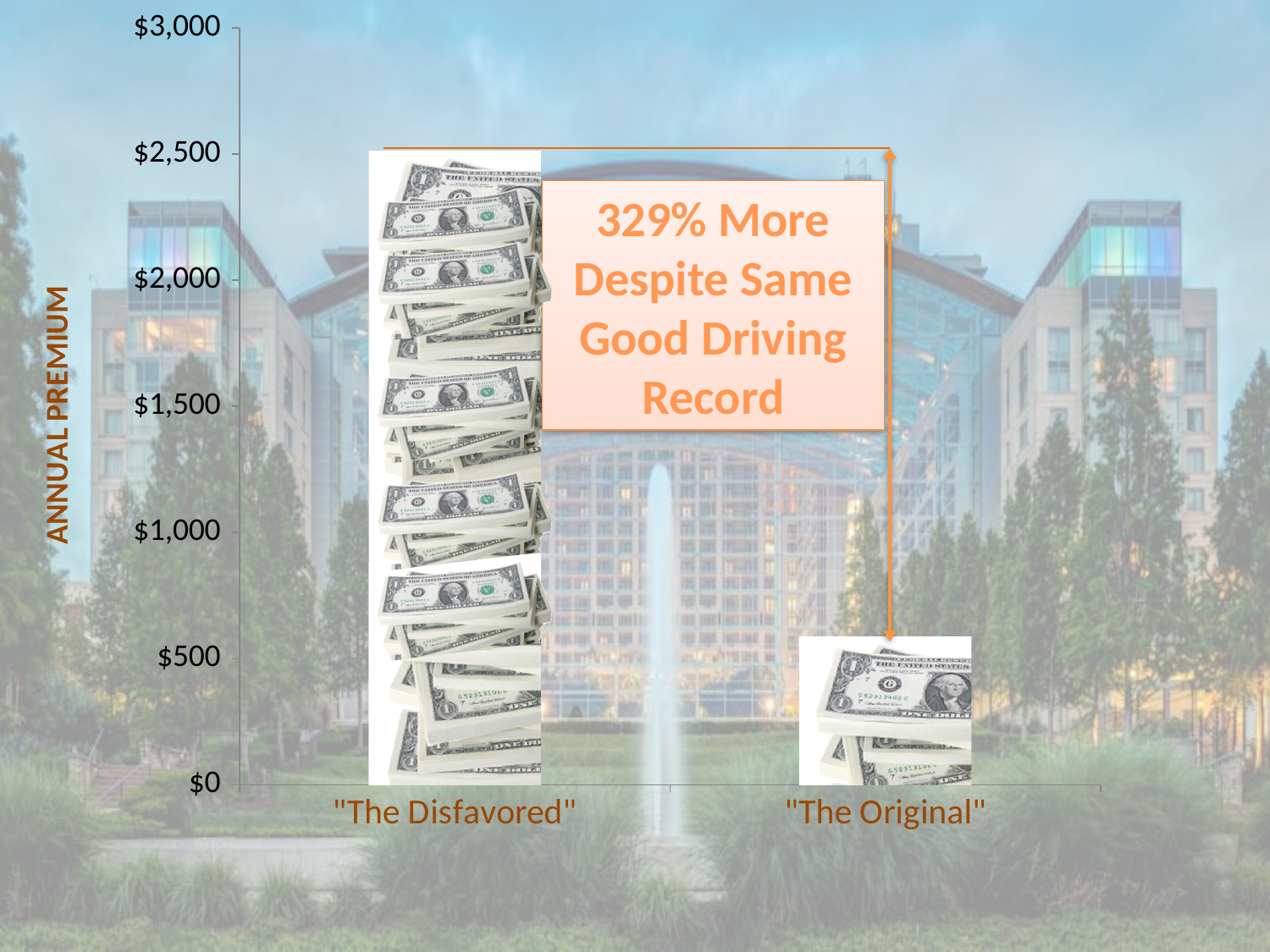
What is the title of the vertical axis? ANNUAL PREMIUM Is the value for "The Disfavored" greater or less than $2,000? greater What does the text box on the chart say? 329% More Despite Same Good Driving Record How many categories are shown on the x axis of the chart? 2 Is the value for "The Disfavored" greater or less than $3,000? less Is the value for "The Original" greater or less than $1,000? less What is the highest value shown on the vertical axis? $3,000 Which category has the lowest annual premium? "The Original" Which has a larger annual premium, "The Disfavored" or "The Original"? "The Disfavored" What kind of chart is shown on the slide? bar chart Which category has the highest annual premium? "The Disfavored"